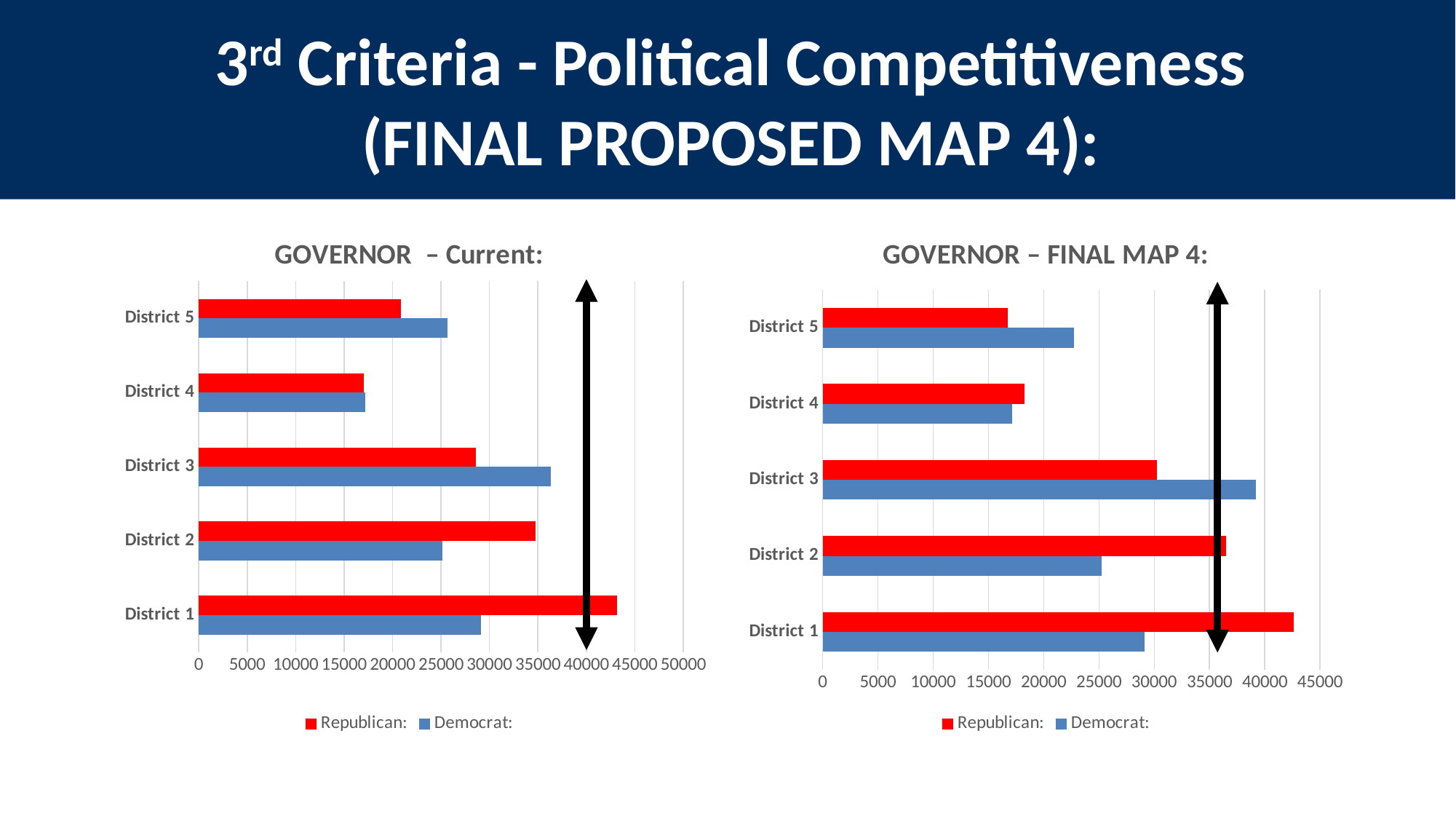
On the GOVERNOR – Current chart, is the Republican value for District 1 greater or less than 40000? greater On the GOVERNOR – FINAL MAP 4 chart, which is larger for District 2, the Republican or the Democrat value? Republican How many districts are shown on the GOVERNOR – Current chart? 5 On the GOVERNOR – FINAL MAP 4 chart, is the Republican value for District 2 greater or less than 35000? greater What are the two legend entries on the GOVERNOR – Current chart? Republican and Democrat What kind of chart is the GOVERNOR – Current chart? bar chart On the GOVERNOR – Current chart, which district has the lowest Republican value? District 4 On the GOVERNOR – FINAL MAP 4 chart, is the Democrat value for District 5 greater or less than 20000? greater How many series does the legend of the GOVERNOR – FINAL MAP 4 chart list? 2 On the GOVERNOR – FINAL MAP 4 chart, which district has the highest Democrat value? District 3 On the GOVERNOR – Current chart, which district has the highest Republican value? District 1 On the GOVERNOR – Current chart, which is larger for District 3, the Republican or the Democrat value? Democrat